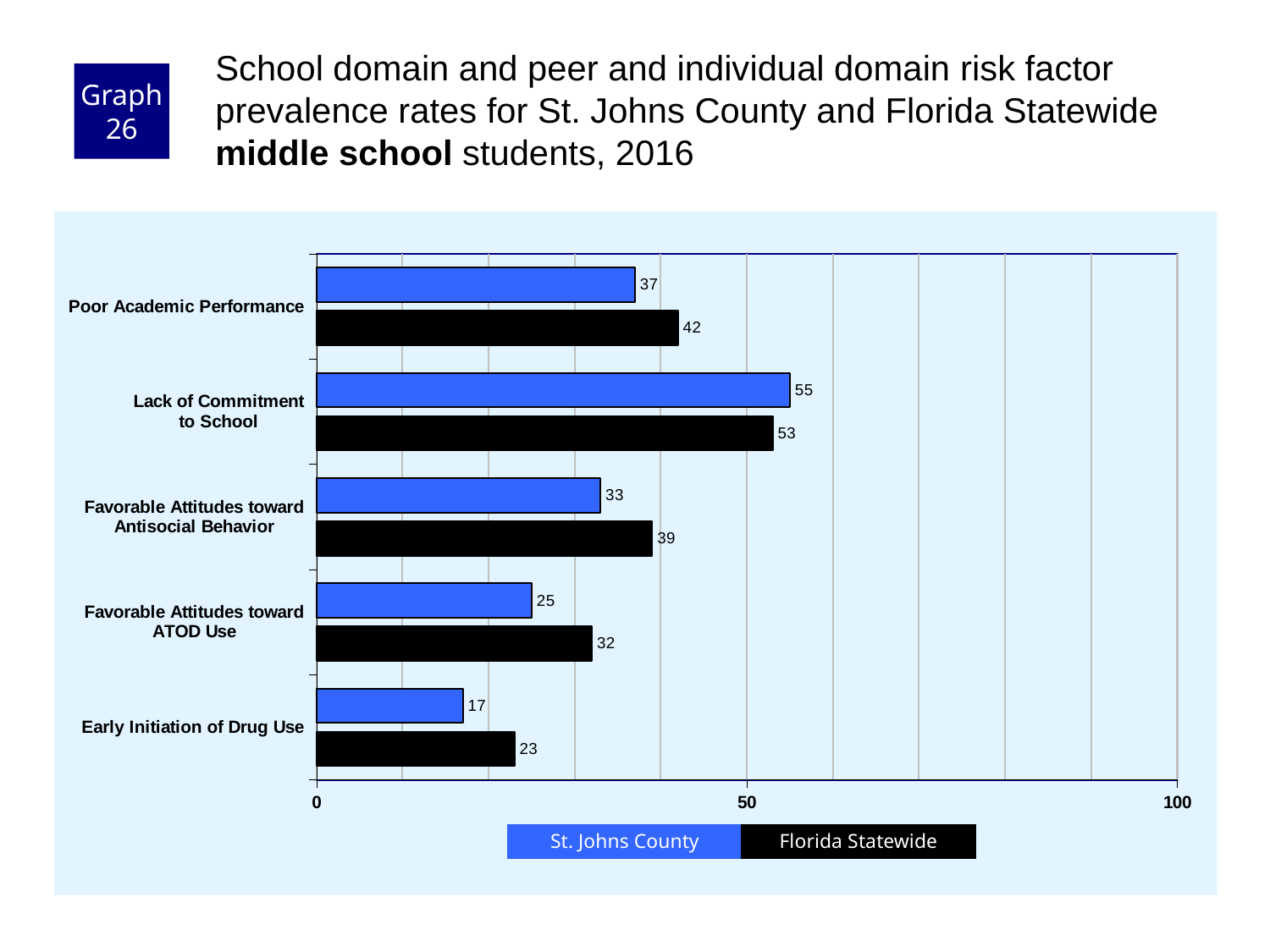
What is the St. Johns County value for Poor Academic Performance? 37 Is the Florida Statewide value for Lack of Commitment to School greater or less than 50? greater Which risk factor has the highest St. Johns County value? Lack of Commitment to School What is the Florida Statewide value for Favorable Attitudes toward ATOD Use? 32 What is the Florida Statewide value for Early Initiation of Drug Use? 23 How many risk factor categories are shown in the chart? 5 For Lack of Commitment to School, which is larger: St. Johns County or Florida Statewide? St. Johns County How many series does the legend list? 2 Which colour represents Florida Statewide in the chart? black What is the difference between the Florida Statewide and St. Johns County values for Favorable Attitudes toward Antisocial Behavior? 6 Which risk factor has the lowest Florida Statewide value? Early Initiation of Drug Use What type of chart is shown on the slide? bar chart